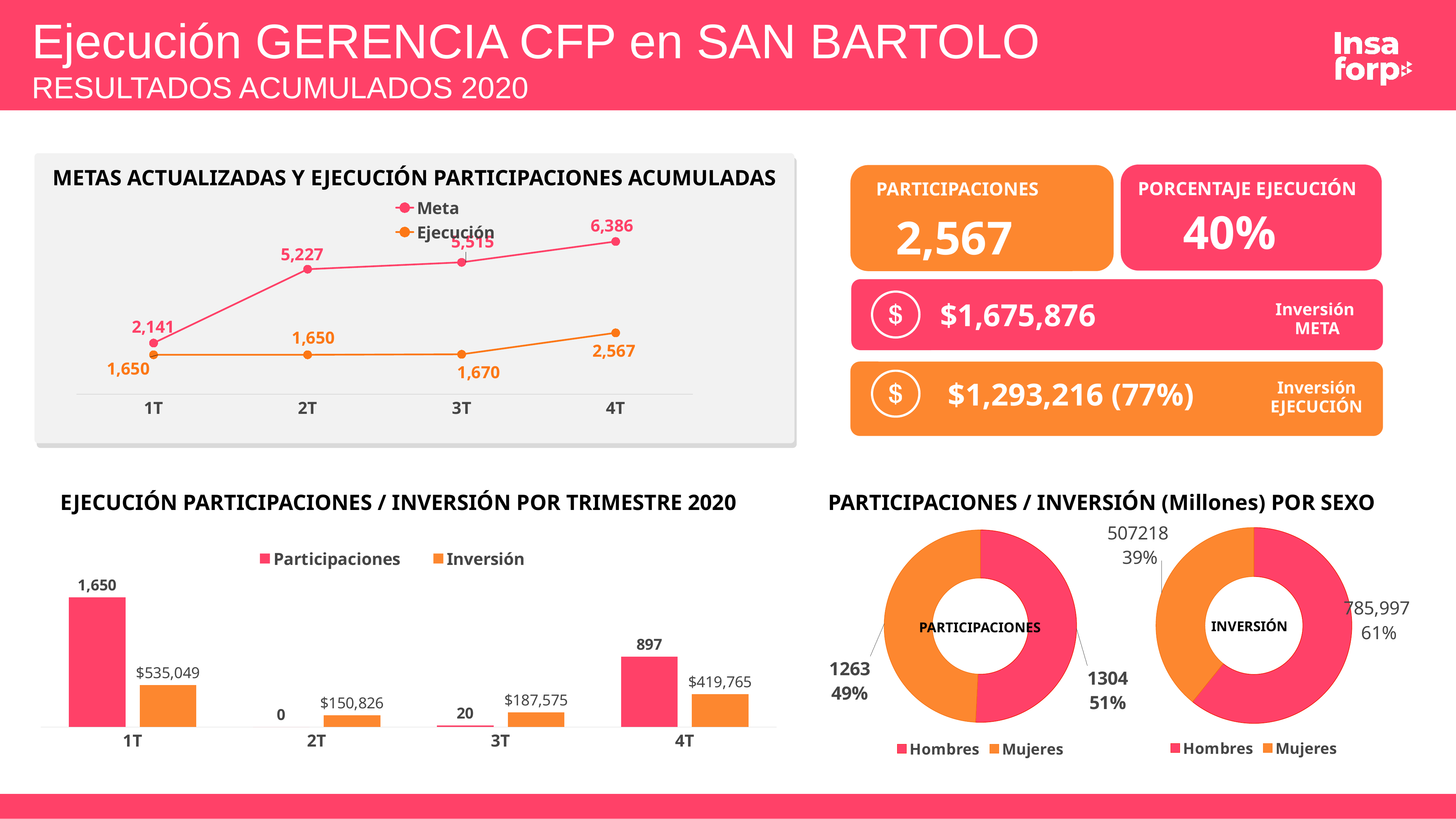
In the PARTICIPACIONES donut chart under 'PARTICIPACIONES / INVERSIÓN (Millones) POR SEXO', what share do Mujeres represent? 49% In the INVERSIÓN donut chart under 'PARTICIPACIONES / INVERSIÓN (Millones) POR SEXO', what is the value for Hombres? 785,997 In the chart 'EJECUCIÓN PARTICIPACIONES / INVERSIÓN POR TRIMESTRE 2020', which quarter has the highest Participaciones value? 1T How many quarters are shown on the x axis of the chart 'EJECUCIÓN PARTICIPACIONES / INVERSIÓN POR TRIMESTRE 2020'? 4 In the chart 'METAS ACTUALIZADAS Y EJECUCIÓN PARTICIPACIONES ACUMULADAS', what is the Meta value at 4T? 6,386 How many series does the legend of the chart 'EJECUCIÓN PARTICIPACIONES / INVERSIÓN POR TRIMESTRE 2020' list? 2 In the chart 'METAS ACTUALIZADAS Y EJECUCIÓN PARTICIPACIONES ACUMULADAS', what is the Ejecución value at 3T? 1,670 In the chart 'METAS ACTUALIZADAS Y EJECUCIÓN PARTICIPACIONES ACUMULADAS', does the Meta series rise or fall from 1T to 4T? rise In the chart 'EJECUCIÓN PARTICIPACIONES / INVERSIÓN POR TRIMESTRE 2020', what is the Inversión value for 2T? $150,826 In the chart 'METAS ACTUALIZADAS Y EJECUCIÓN PARTICIPACIONES ACUMULADAS', what is the difference between Meta and Ejecución at 4T? 3,819 What kind of chart is 'METAS ACTUALIZADAS Y EJECUCIÓN PARTICIPACIONES ACUMULADAS'? line chart In the chart 'EJECUCIÓN PARTICIPACIONES / INVERSIÓN POR TRIMESTRE 2020', which quarter has the lowest Inversión value? 2T